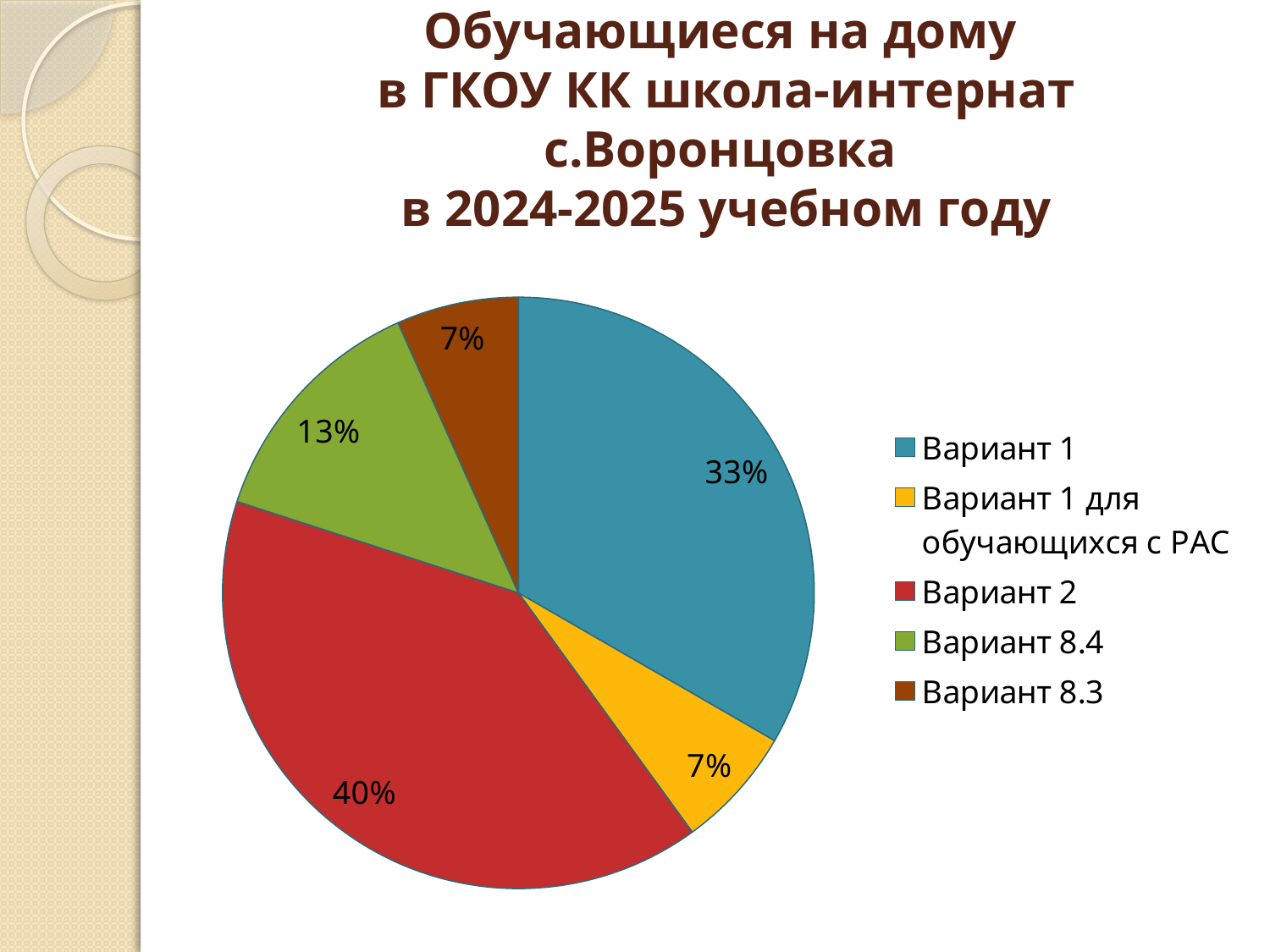
What colour is the slice for Вариант 2? red What share of the pie does Вариант 8.4 have? 13% Which category has the largest slice of the pie? Вариант 2 What share of the pie does Вариант 2 have? 40% What share of the pie does Вариант 1 для обучающихся с РАС have? 7% What kind of chart is shown on the slide? pie chart What is the difference between the shares of Вариант 2 and Вариант 1? 7% Which is larger, the share of Вариант 8.4 or the share of Вариант 8.3? Вариант 8.4 What is the difference between the shares of Вариант 1 and Вариант 8.4? 20% How many categories does the pie chart show? 5